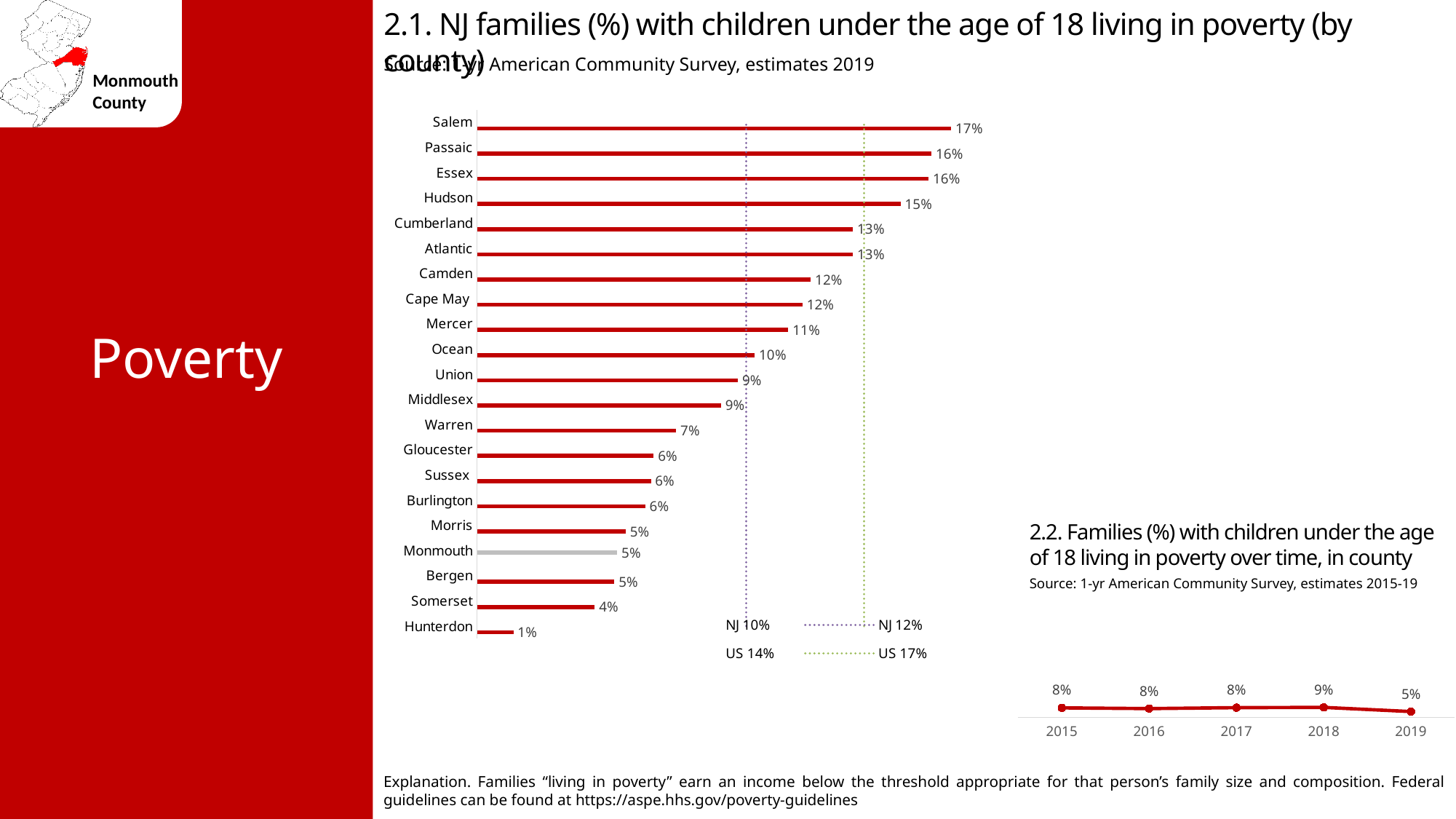
In chart 2.1 (by county), what is the difference between Salem and Hunterdon? 16% In chart 2.1 (by county), which county has the highest percentage of families with children living in poverty? Salem In chart 2.1 (by county), which is larger, the value for Mercer or the value for Ocean? Mercer In chart 2.1 (NJ families with children under 18 living in poverty by county), what is the value for Monmouth? 5% In chart 2.1 (by county), which county has the lowest percentage? Hunterdon In chart 2.2 (families in poverty over time, in county), what is the value for 2019? 5% In chart 2.1 (by county), what is the value for Hudson? 15% In chart 2.2 (over time, in county), what is the difference between 2018 and 2019? 4% What kind of chart is chart 2.1 (by county)? Bar chart In chart 2.1 (by county), how many counties are shown? 21 In chart 2.2 (over time, in county), which year has the highest value? 2018